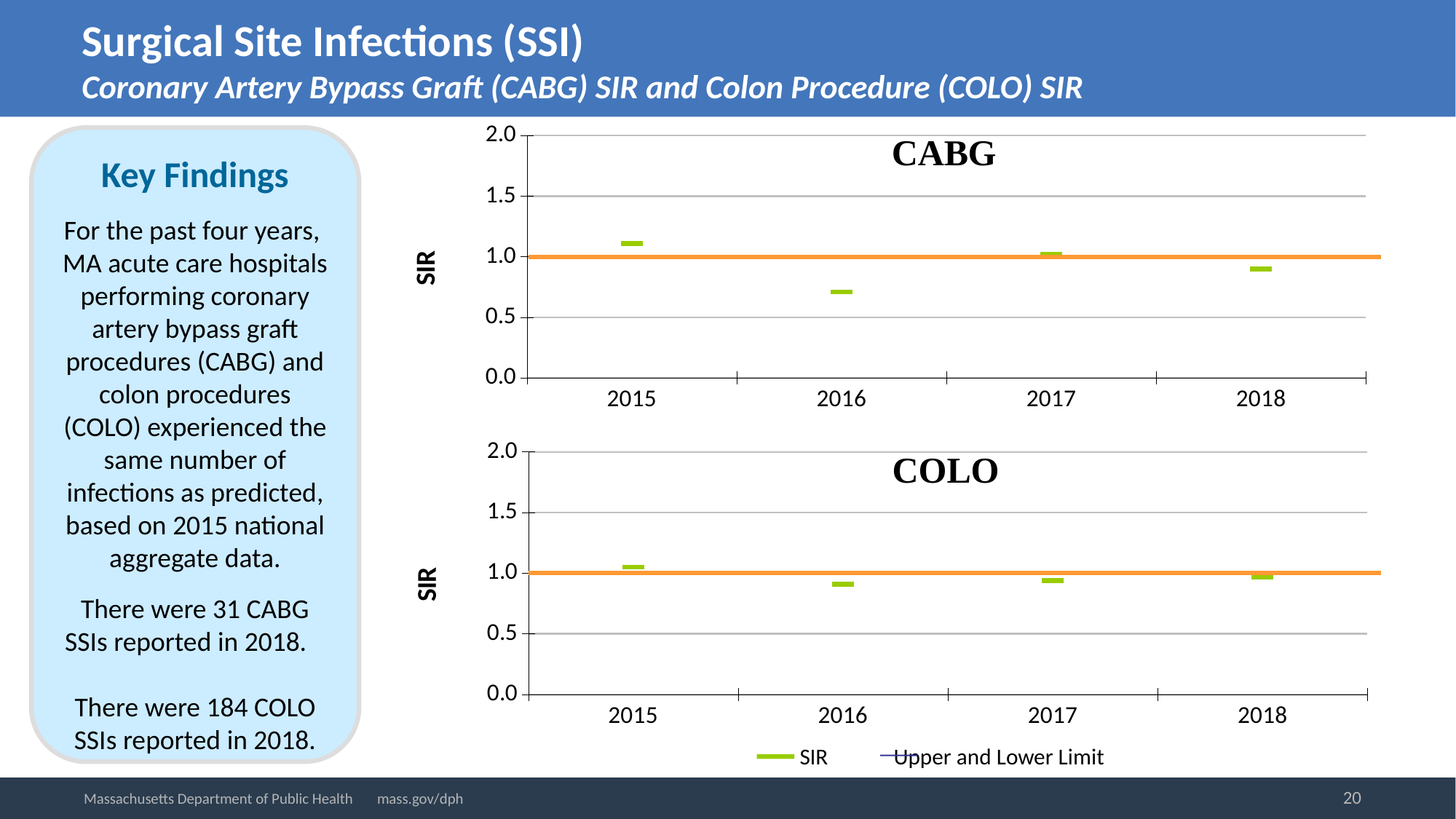
In the CABG chart, which year has the highest SIR? 2015 How many series does the legend at the bottom of the slide list? 2 In the COLO chart, is the SIR for 2016 greater or less than 1.0? less In the COLO chart, which year has the highest SIR? 2015 How many charts are shown on the slide? 2 In the CABG chart, is the SIR for 2015 greater or less than 1.0? greater In the CABG chart, how many years are plotted on the x axis? 4 In the CABG chart, which year has the lowest SIR? 2016 What are the two entries listed in the legend? SIR; Upper and Lower Limit In the CABG chart, is the SIR for 2016 greater or less than 1.0? less In the CABG chart, which year has the larger SIR, 2015 or 2016? 2015